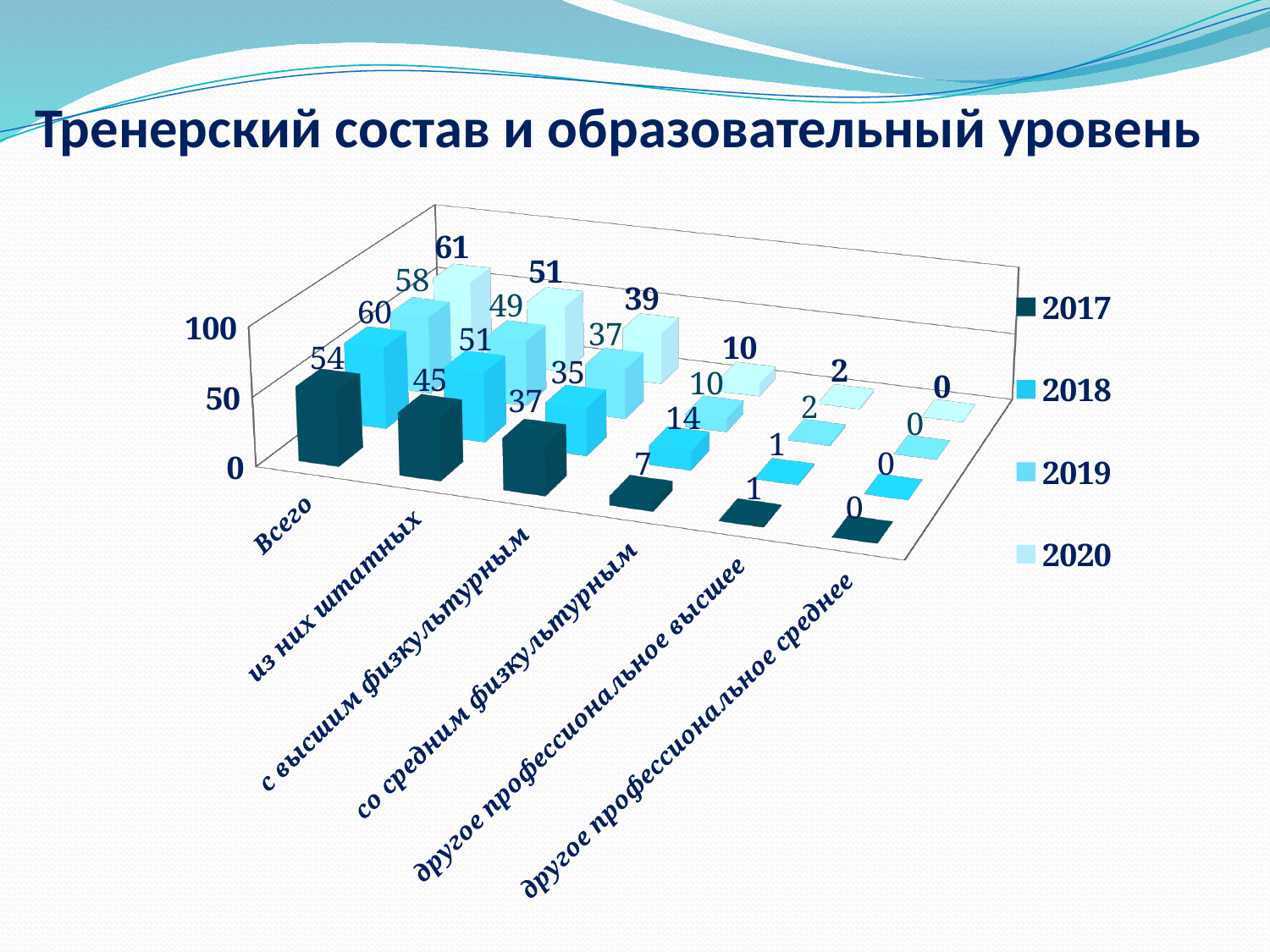
What is the value for 2020 in the "Всего" category? 61 What is the title of the chart? Тренерский состав и образовательный уровень How many series does the legend list? 4 How many categories are shown on the x axis? 6 What is the value for 2018 in the "со средним физкультурным" category? 14 What kind of chart is shown on the slide? bar chart Which year has the lowest value in the "со средним физкультурным" category? 2017 Which is larger: the 2018 value or the 2019 value for "с высшим физкультурным"? 2019 Which year has the highest value in the "Всего" category? 2020 What is the value for 2017 in the "из них штатных" category? 45 What is the value for 2019 in the "другое профессиональное высшее" category? 2 What is the difference between the 2020 and 2017 values in the "Всего" category? 7